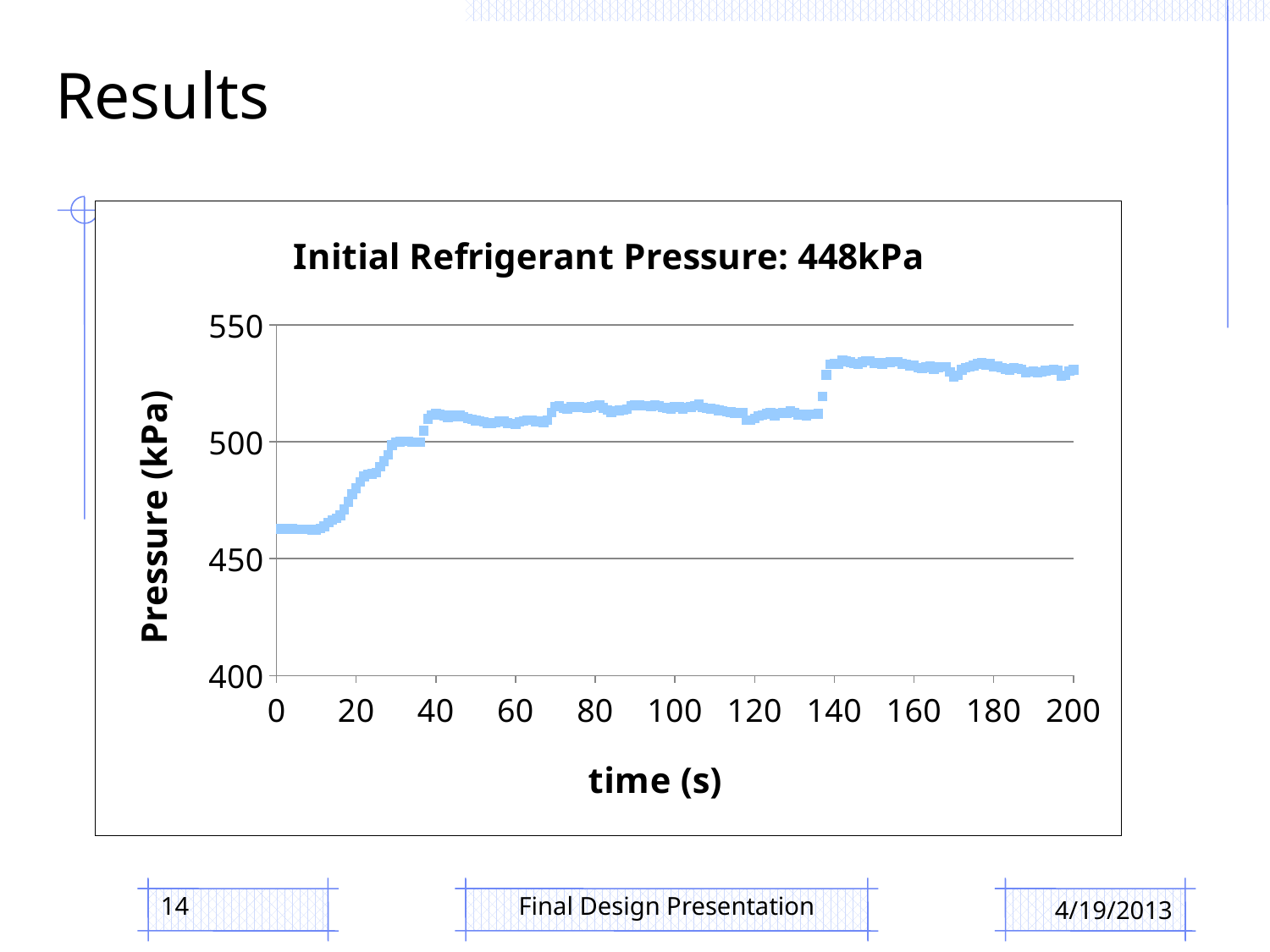
What kind of chart is shown on the slide? scatter chart What is the label of the vertical axis? Pressure (kPa) Which is larger, the pressure at time 0 s or at time 100 s? 100 s Which is larger, the pressure at time 60 s or at time 160 s? 160 s Is the pressure at time 0 s greater or less than 500? less Is the pressure at time 100 s greater or less than 500? greater What is the highest value shown on the vertical axis? 550 What is the title of the chart? Initial Refrigerant Pressure: 448kPa Is the pressure at time 160 s greater or less than 550? less Overall, does the pressure rise or fall as time increases from 0 to 200 s? rise